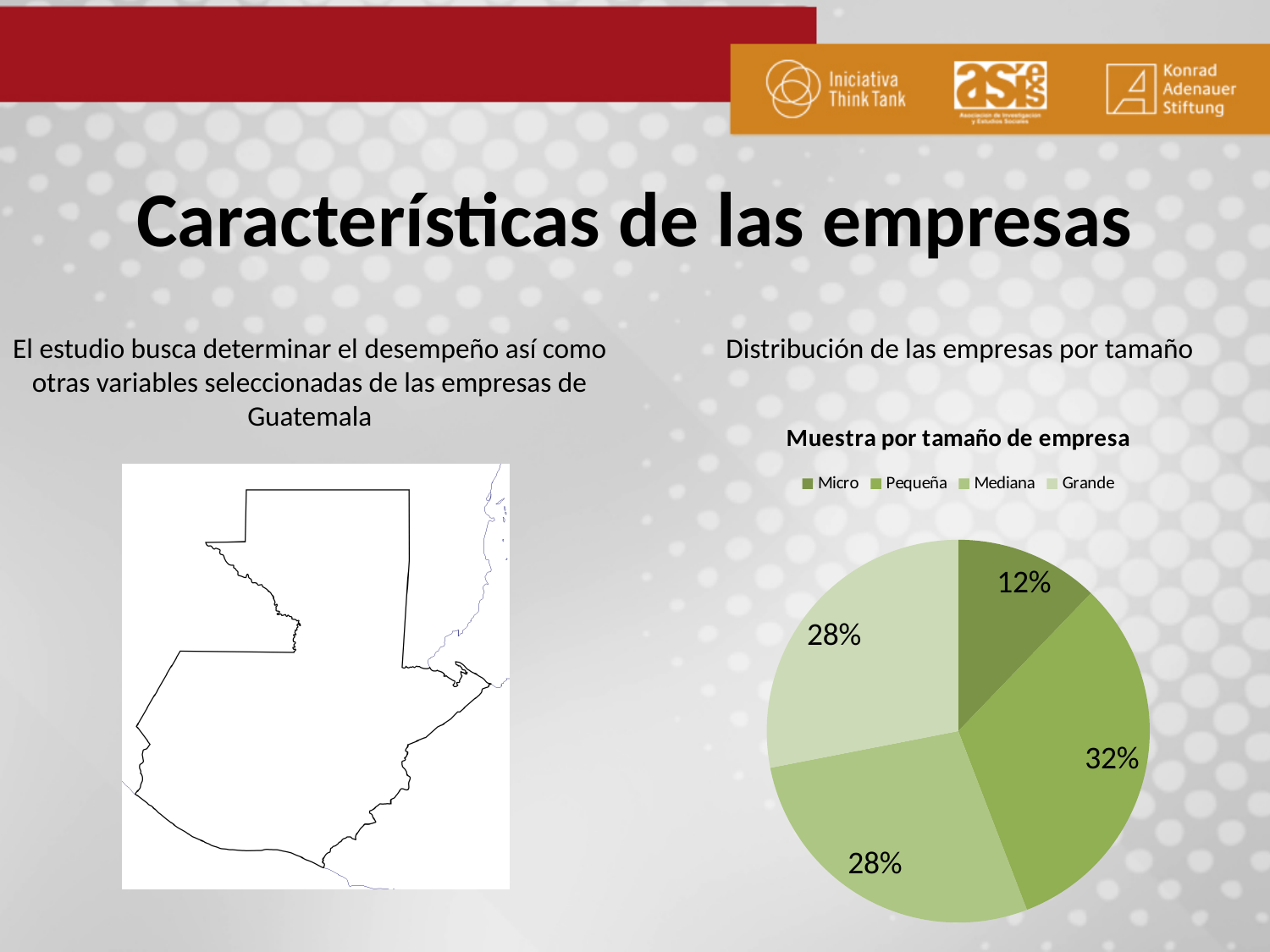
What share of the pie does Grande represent? 28% Which company size category has the smallest share of the sample? Micro What is the title of the chart? Muestra por tamaño de empresa What type of chart is shown on the slide? pie chart How many categories does the legend of the pie chart list? 4 Which company size category has the largest share of the sample? Pequeña What is the difference in percentage points between the Pequeña and Micro shares? 20 How many slices does the pie chart have? 4 What share of the pie does Mediana represent? 28% Which has a larger share, Micro or Grande? Grande What share of the pie does Micro represent? 12% What share of the pie does Pequeña represent? 32%